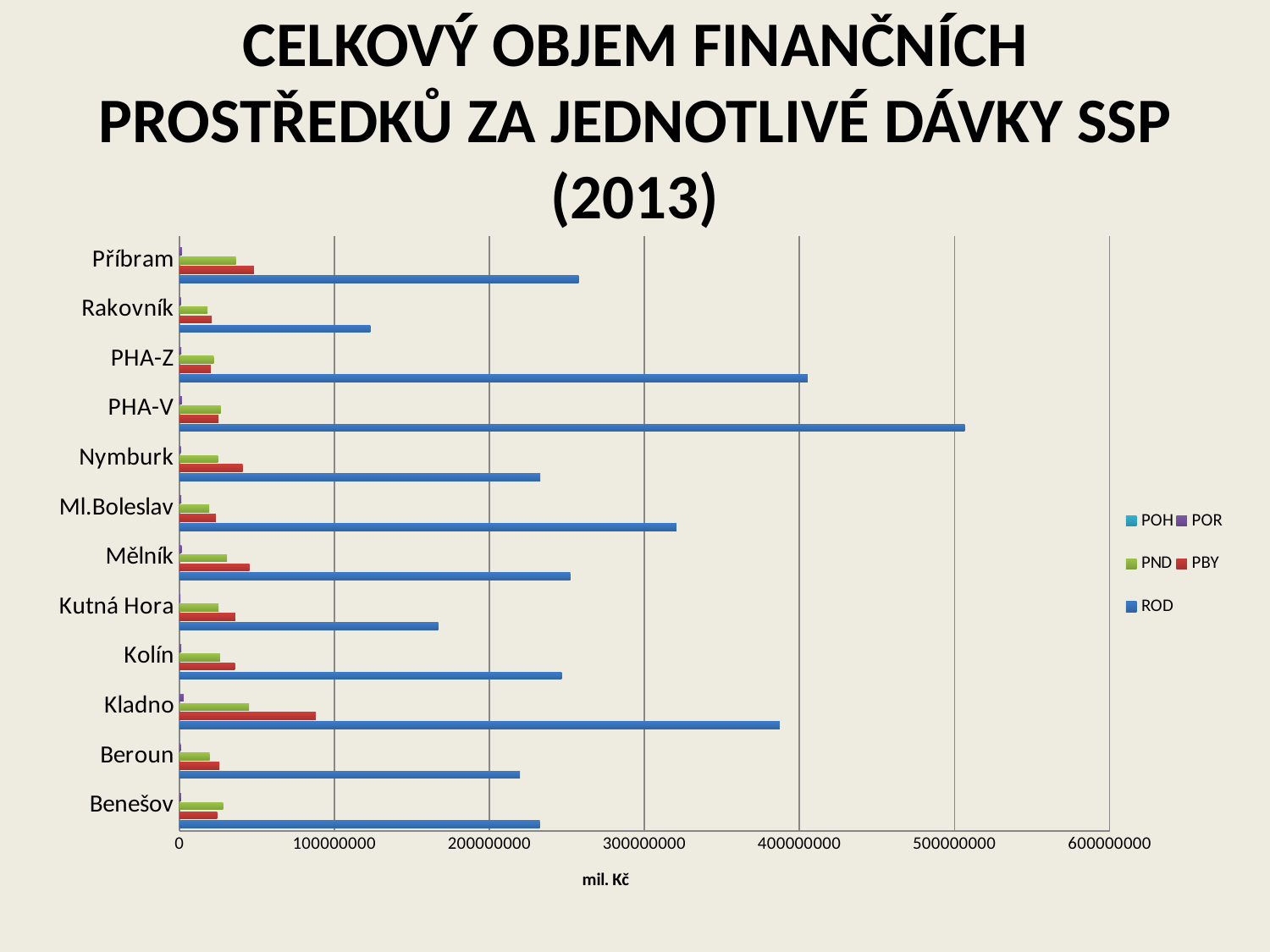
What kind of chart is shown on the slide? bar chart Is the ROD value for Ml.Boleslav greater or less than 300000000? greater Is the ROD value for Kutná Hora greater or less than 200000000? less What is the label of the horizontal axis? mil. Kč Which category has the highest ROD value? PHA-V Is the ROD value for PHA-V greater or less than 400000000? greater How many series does the legend list? 5 Which category has the lowest ROD value? Rakovník Which category has the highest PBY value? Kladno How many categories (districts) are listed on the vertical axis? 12 Which is larger, the ROD value for Kladno or the ROD value for Kolín? Kladno